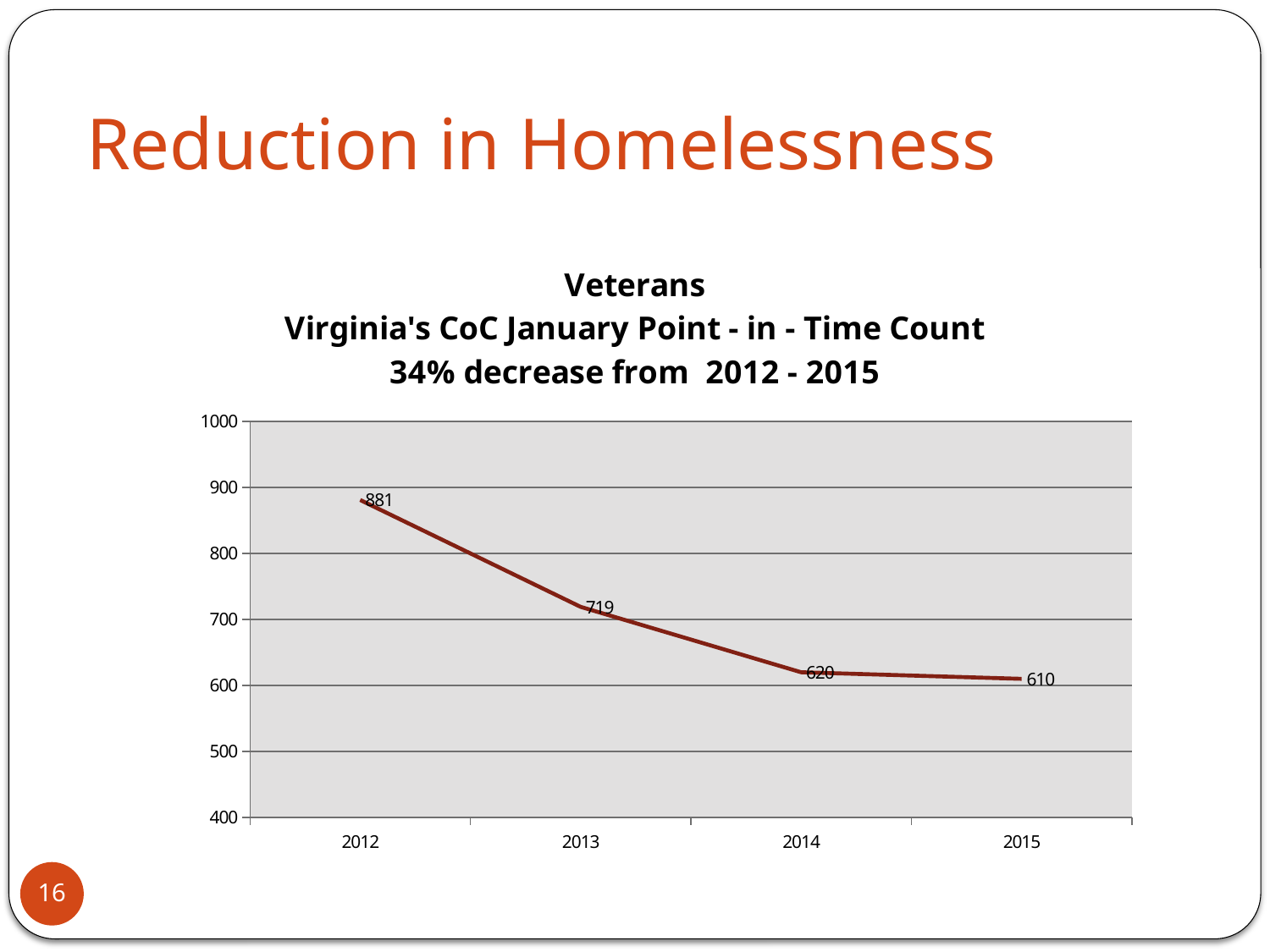
What is the difference between the values for 2012 and 2015? 271 What is the difference between the values for 2013 and 2014? 99 What is the value for 2013? 719 Which year has the lowest value? 2015 How many years are plotted on the chart? 4 Which is larger, the value for 2013 or the value for 2014? 2013 What is the value for 2015? 610 Which year has the highest value? 2012 Do the values rise or fall from 2012 to 2015? fall What is the value for 2012? 881 What kind of chart is shown? line chart What is the value for 2014? 620